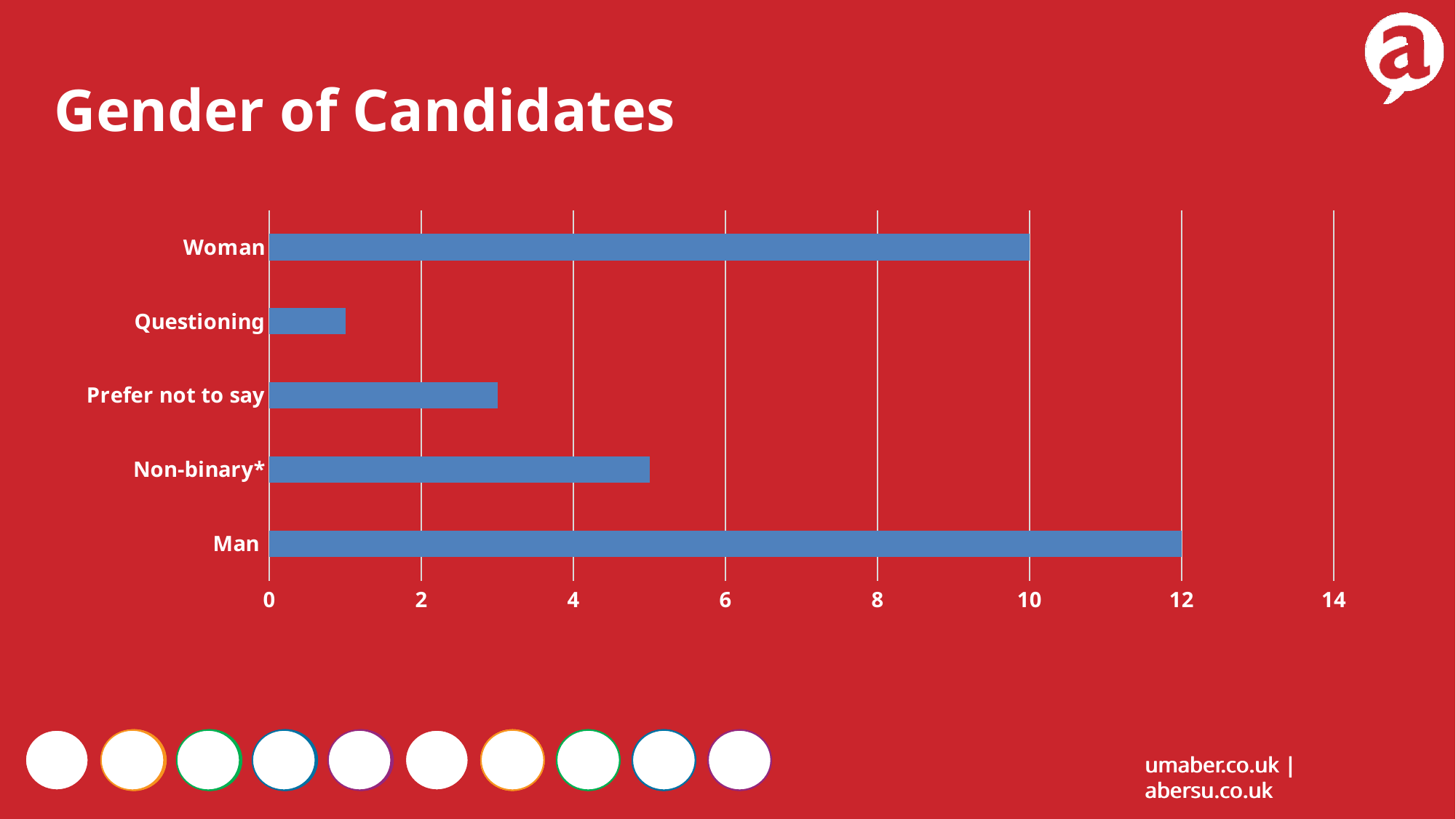
Is the value for Non-binary* greater or less than 4? greater Which category has the highest value? Man What is the value for Woman? 10 How many categories are shown in the chart? 5 What type of chart is shown on the slide? bar chart Is the value for Prefer not to say greater or less than 4? less What is the value for Man? 12 Which is larger, the value for Non-binary* or the value for Prefer not to say? Non-binary* Is the value for Questioning greater or less than 2? less What is the title of the chart? Gender of Candidates What is the difference between the values for Man and Woman? 2 Which category has the lowest value? Questioning